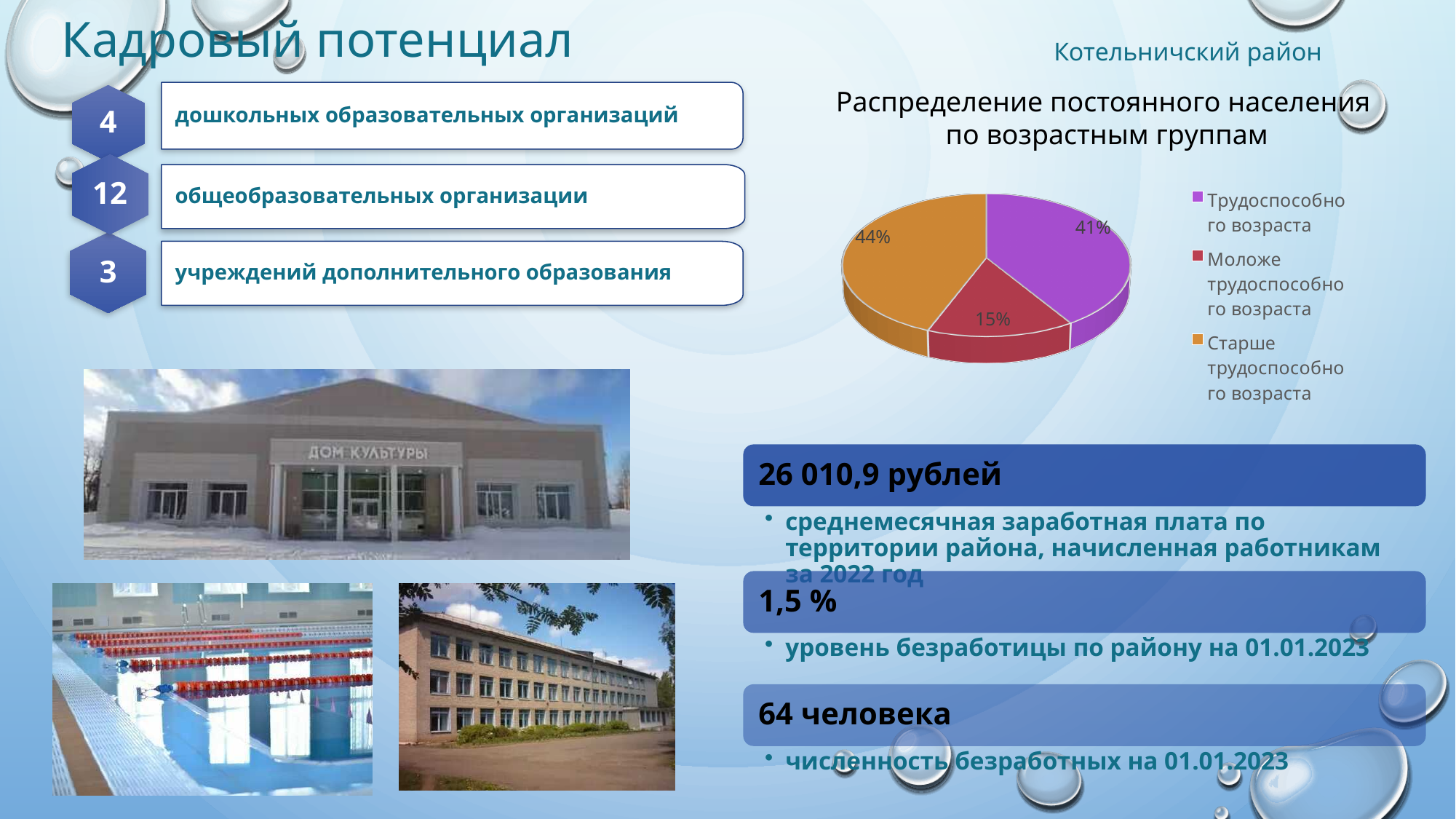
What is the title of the pie chart? Распределение постоянного населения по возрастным группам What is the difference in percentage points between the share older than working age and the share younger than working age? 29 Which age group has the smallest share of the population? Моложе трудоспособного возраста Which is larger: the share of working age or the share younger than working age? Трудоспособного возраста What colour is the slice for Старше трудоспособного возраста? orange What share of the population is younger than working age (Моложе трудоспособного возраста)? 15% What is the difference in percentage points between the share older than working age and the share of working age? 3 Which age group has the largest share of the population? Старше трудоспособного возраста What kind of chart is shown on the slide? pie chart What share of the population is of working age (Трудоспособного возраста)? 41% How many age groups are shown in the pie chart? 3 What share of the population is older than working age (Старше трудоспособного возраста)? 44%